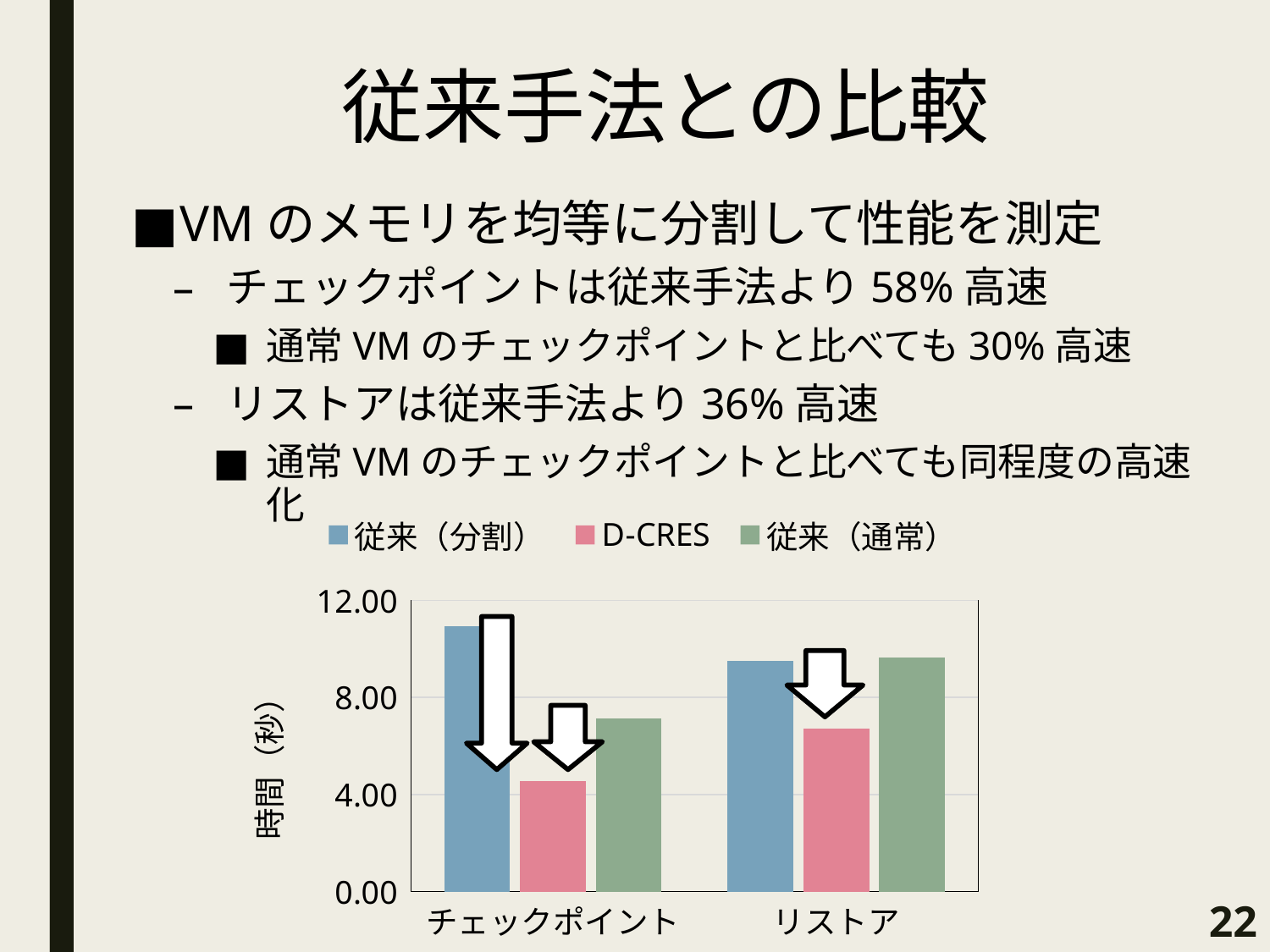
Which series has the lowest value for チェックポイント? D-CRES How many categories are shown on the x axis of the chart? 2 How many series does the chart legend list? 3 Is the value of D-CRES for チェックポイント greater or less than 8.00? less Is the value of 従来（分割） for チェックポイント greater or less than 8.00? greater What kind of chart is shown on the slide? bar chart For the D-CRES series, which category has the larger value, チェックポイント or リストア? リストア Which series has the lowest value for リストア? D-CRES What is the label of the vertical axis of the chart? 時間（秒） Is the value of 従来（通常） for リストア greater or less than 8.00? greater Which series has the highest value for チェックポイント? 従来（分割）